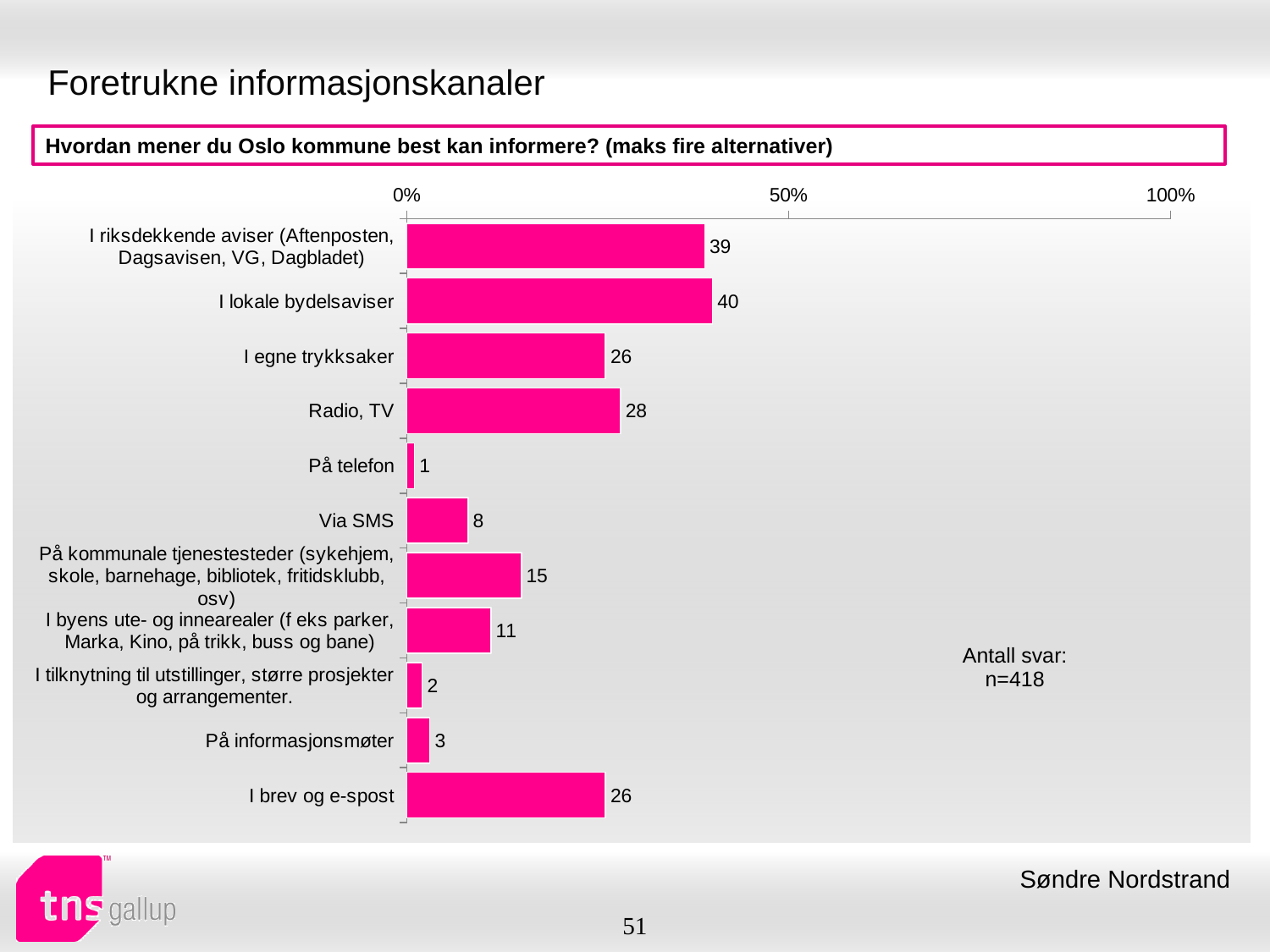
Which category has the lowest value? På telefon How many categories are shown in the chart? 11 What is the value for 'Radio, TV'? 28 Which is larger, the value for 'Radio, TV' or the value for 'I egne trykksaker'? Radio, TV What is the difference between the values for 'På kommunale tjenestesteder (sykehjem, skole, barnehage, bibliotek, fritidsklubb, osv)' and 'I byens ute- og innearealer (f eks parker, Marka, Kino, på trikk, buss og bane)'? 4 Is the value for 'I brev og e-spost' greater or less than 50%? less Which category has the highest value? I lokale bydelsaviser What is the value for 'I lokale bydelsaviser'? 40 What kind of chart is shown on the slide? bar chart What is the value for 'Via SMS'? 8 What is the difference between the values for 'I lokale bydelsaviser' and 'I riksdekkende aviser (Aftenposten, Dagsavisen, VG, Dagbladet)'? 1 What is the number of responses (Antall svar) shown on the slide? n=418